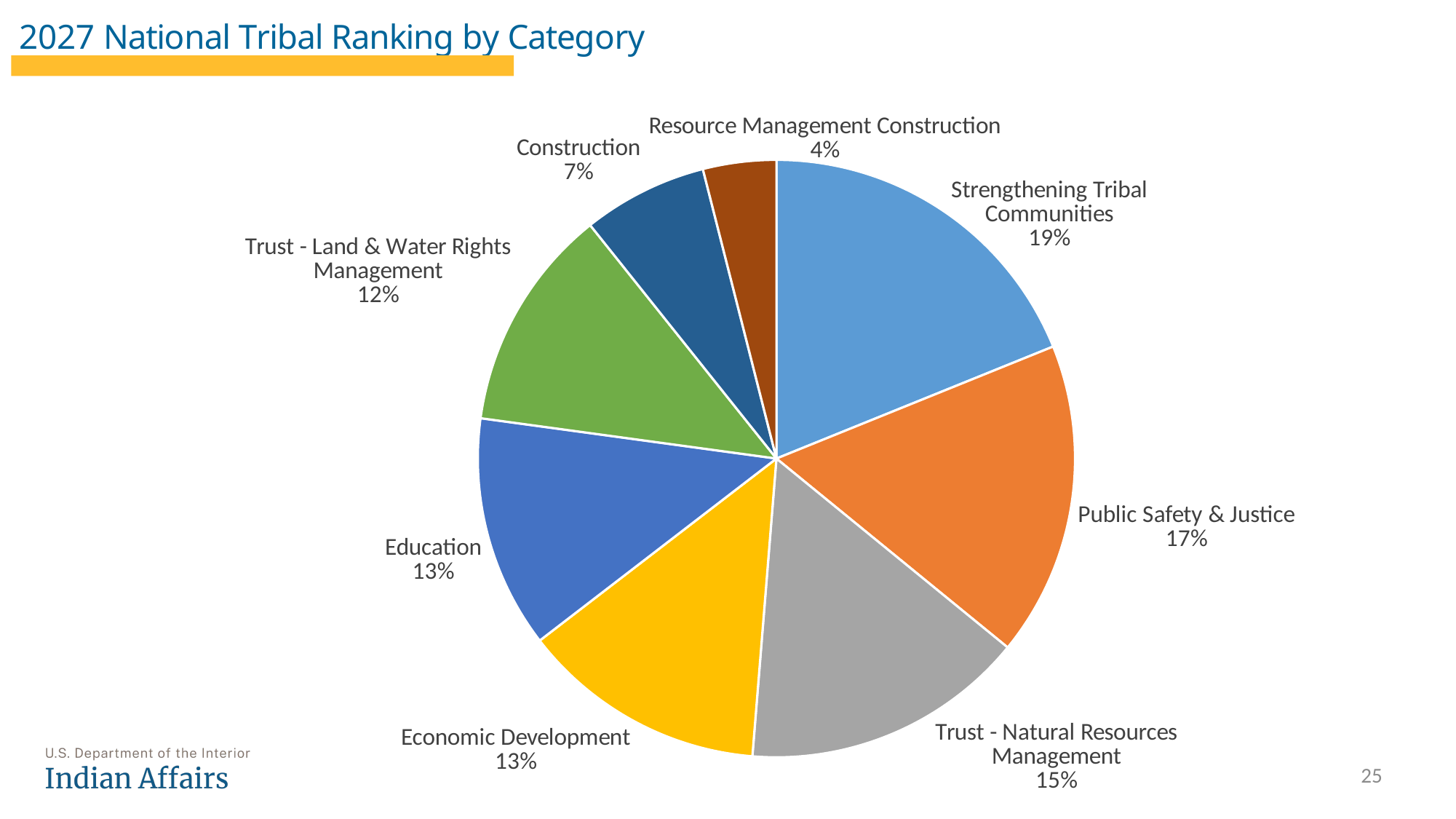
What share of the pie does Strengthening Tribal Communities represent? 19% Which is larger, the share for Education or the share for Construction? Education What is the value shown for Trust - Land & Water Rights Management? 12% What is the difference between the shares for Public Safety & Justice and Construction? 10% What colour is the slice for Economic Development? Yellow What type of chart is shown on the slide? Pie chart What is the value shown for Public Safety & Justice? 17% What is the title of the chart on the slide? 2027 National Tribal Ranking by Category What is the value shown for Trust - Natural Resources Management? 15% Which category has the largest slice of the pie? Strengthening Tribal Communities Which category has the smallest slice of the pie? Resource Management Construction How many categories are shown in the pie chart? 8